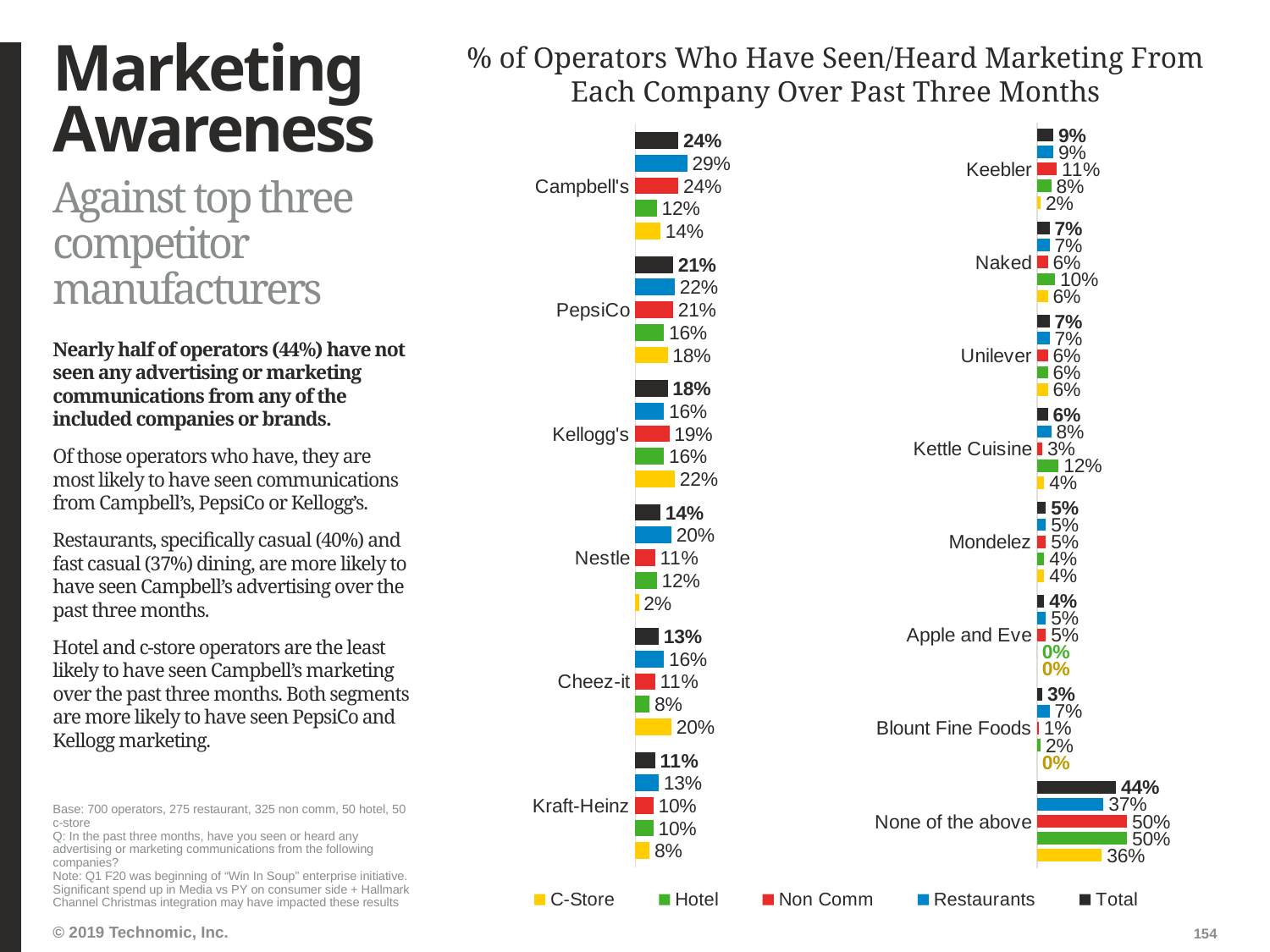
What is the Hotel value for Kettle Cuisine? 12% What is the Restaurants value for Nestle? 20% What is the C-Store value for Kellogg's? 22% Which is larger for Cheez-it: the C-Store value or the Hotel value? C-Store Which company has the highest Total value among the named companies (excluding 'None of the above')? Campbell's Which category has the lowest Total value? Blount Fine Foods What is the Total value for Campbell's? 24% How many categories are shown in the chart, including 'None of the above'? 14 What kind of chart is shown on the slide? Bar chart How many series does the legend list? 5 What is the Non Comm value for 'None of the above'? 50% What is the difference between the Restaurants value and the Hotel value for Campbell's? 17%